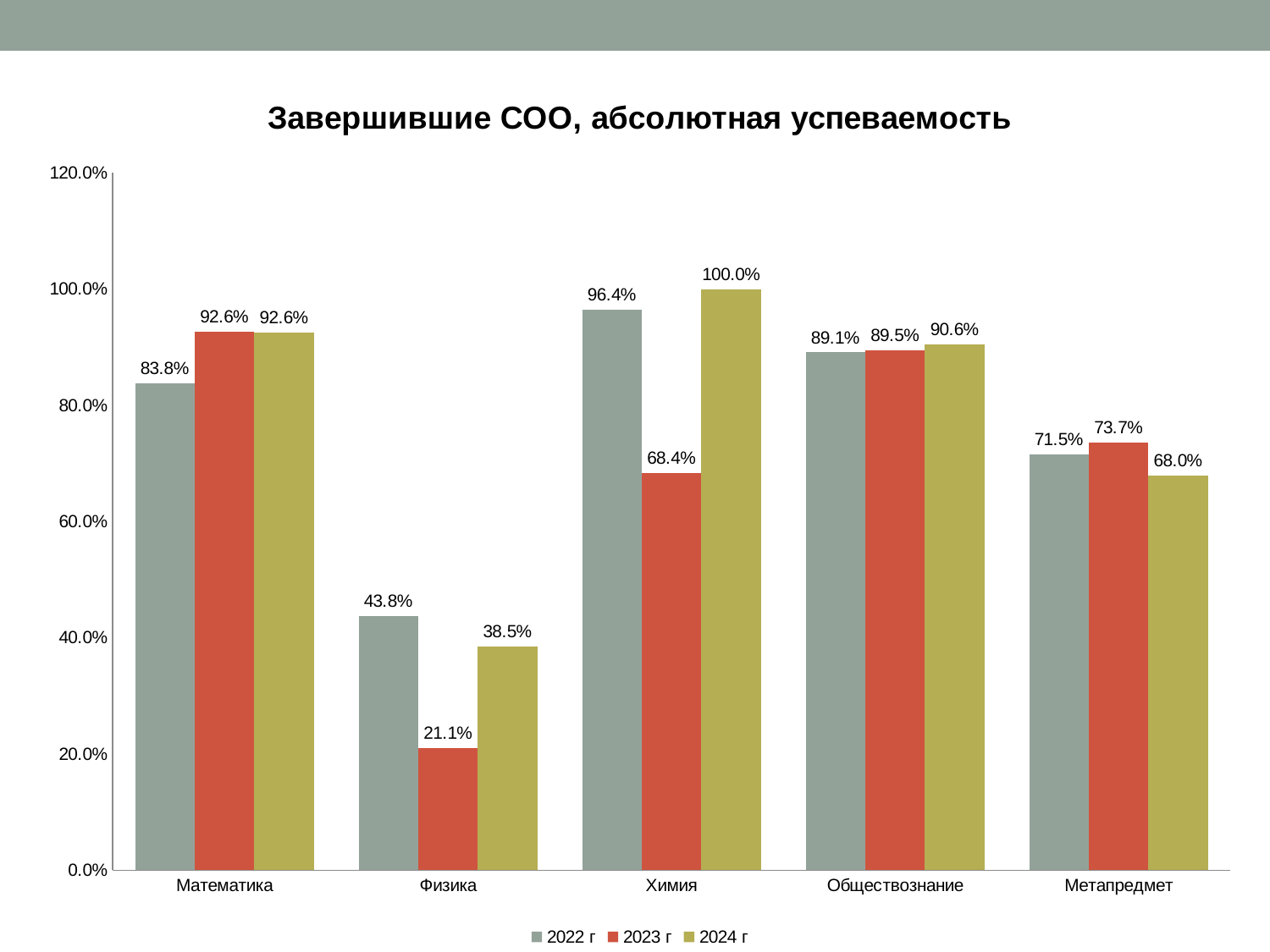
What is the value for Метапредмет in the 2022 г series? 71.5% What is the difference between the 2022 г and 2023 г values for Химия? 28.0% What kind of chart is shown on the slide? Bar chart How many series does the legend list? 3 What is the value for Химия in the 2024 г series? 100.0% Which category has the lowest value in the 2022 г series? Физика Do the values for Обществознание rise or fall from 2022 г to 2024 г? Rise How many categories are shown on the x axis? 5 What is the title of the chart? Завершившие СОО, абсолютная успеваемость Which category has the highest value in the 2024 г series? Химия What is the value for Физика in the 2023 г series? 21.1% Which is larger for Метапредмет: the 2023 г value or the 2024 г value? 2023 г